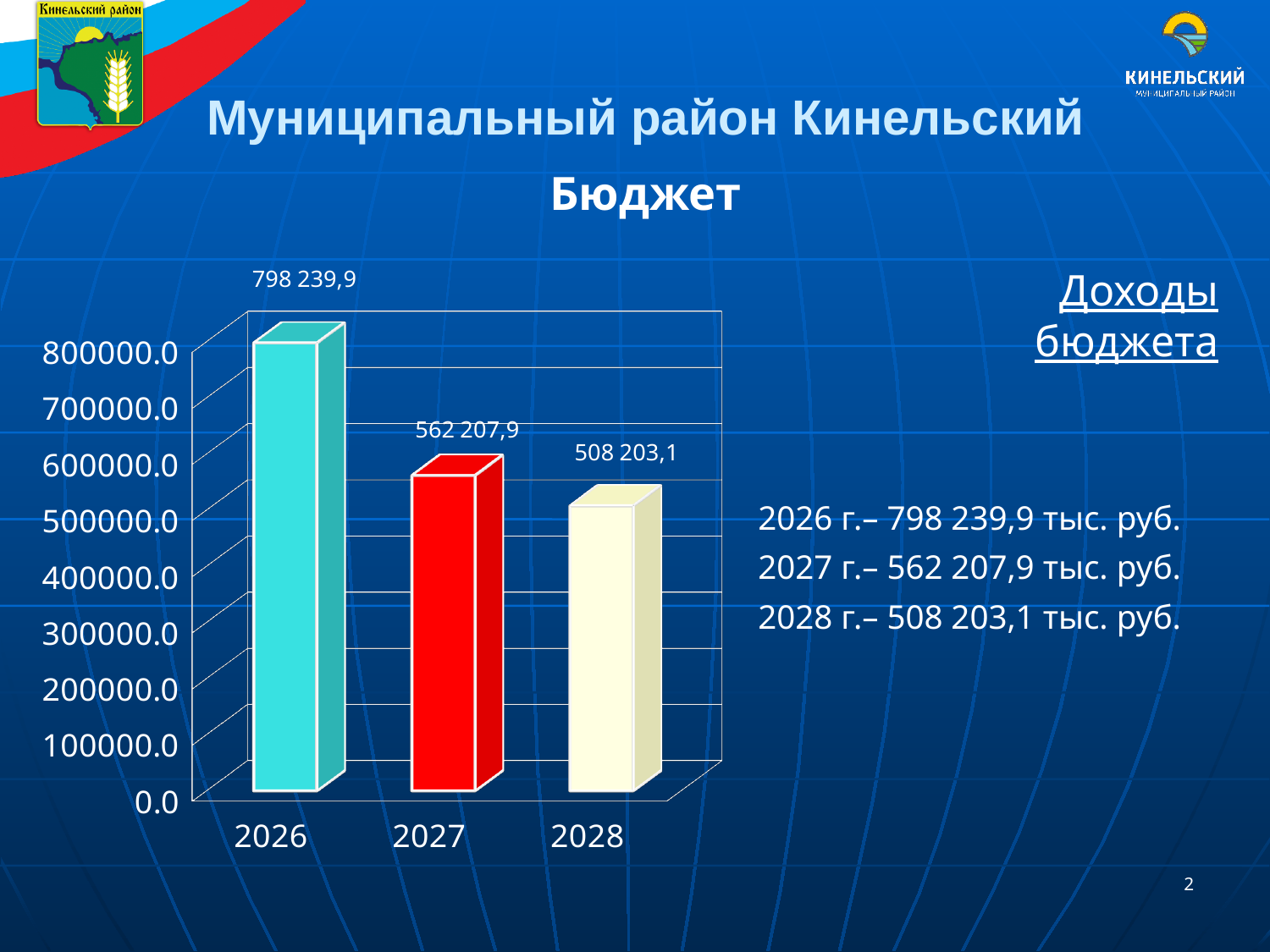
Which year has the lowest value on the chart? 2028 What is the value shown for 2028 on the chart? 508 203,1 How many years are shown on the chart? 3 What is the difference between the values for 2026 and 2027? 236 032,0 Is the value for 2028 greater or less than 600000.0? less Do the values rise or fall from 2026 to 2028? fall What is the value shown for 2027 on the chart? 562 207,9 What kind of chart is shown on the slide? bar chart What is the value shown for 2026 on the chart? 798 239,9 Which is larger, the value for 2027 or the value for 2028? 2027 What is the difference between the values for 2027 and 2028? 54 004,8 Which year has the highest value on the chart? 2026